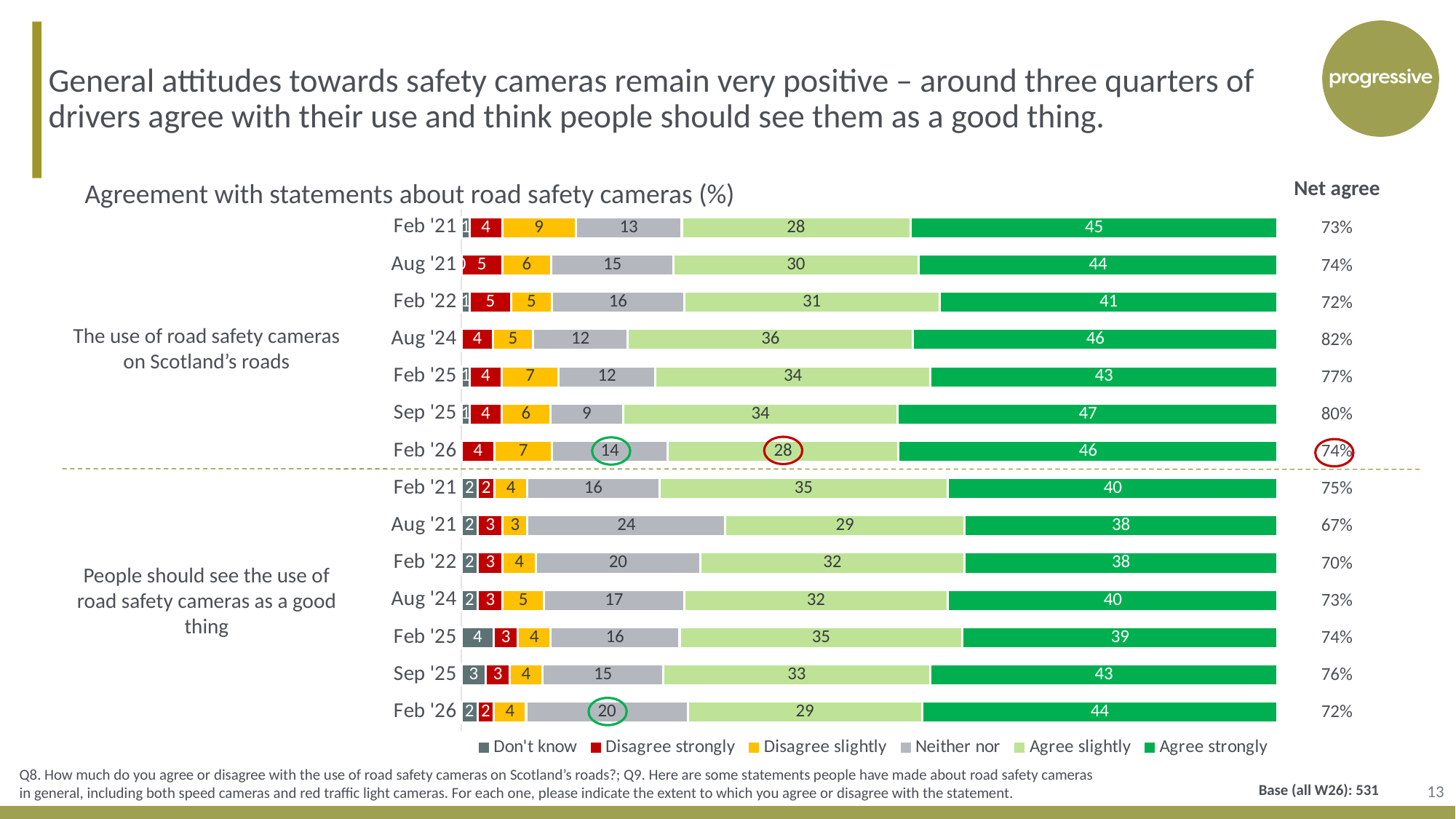
In the 'People should see the use of road safety cameras as a good thing' section, what is the Neither nor value for Feb '26? 20 In the 'The use of road safety cameras on Scotland's roads' section, which wave has the larger Agree slightly value, Aug '24 or Feb '26? Aug '24 In the 'The use of road safety cameras on Scotland's roads' section, what is the Net agree for Sep '25? 80% In the 'People should see the use of road safety cameras as a good thing' section, which wave has the lowest Net agree? Aug '21 In the 'The use of road safety cameras on Scotland's roads' section, what is the Disagree strongly value for Aug '21? 5 In the 'The use of road safety cameras on Scotland's roads' section, which wave has the highest Net agree? Aug '24 In the 'The use of road safety cameras on Scotland's roads' section, what is the difference between the Agree strongly values for Sep '25 and Feb '26? 1 What kind of chart is shown on the slide? Stacked bar chart How many series does the chart legend list? 6 How many survey waves are shown for each statement in the chart? 7 What is the title of the chart? Agreement with statements about road safety cameras (%) In the 'The use of road safety cameras on Scotland's roads' section, what is the Agree strongly value for Feb '26? 46